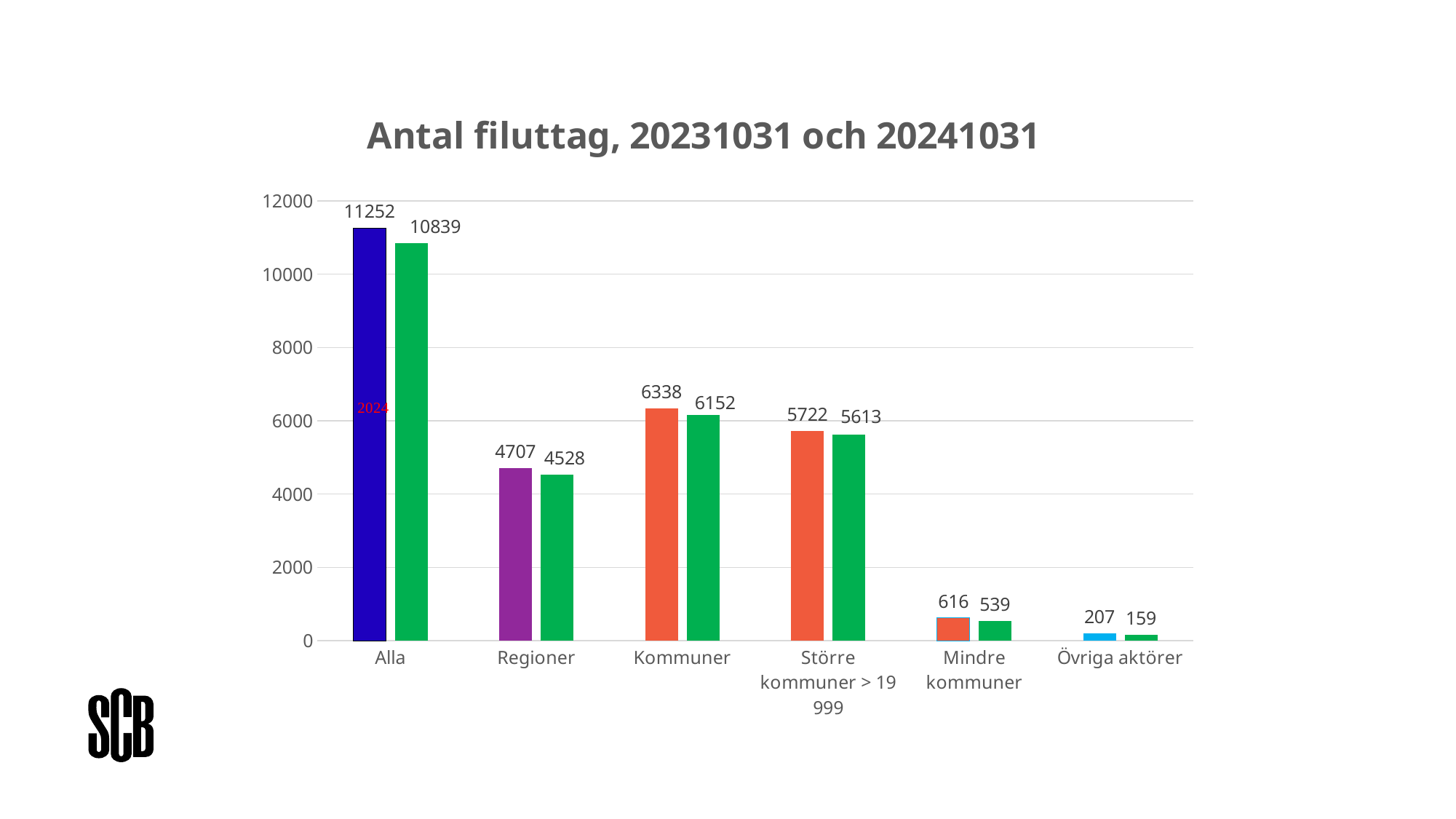
Which category has the highest values in the chart? Alla Which is larger: the left bar for Kommuner or the left bar for Större kommuner > 19 999? Kommuner What is the difference between the two bars for Mindre kommuner (616 and 539)? 77 What is the value shown on the green (right) bar for Övriga aktörer? 159 Is the green bar for Regioner greater or less than 4000? greater What type of chart is shown on the slide? Bar chart What is the difference between the two bars for Alla (11252 and 10839)? 413 What is the value shown on the green (right) bar for Regioner? 4528 Which category has the lowest values in the chart? Övriga aktörer What is the value shown on the left bar for Kommuner? 6338 How many categories are shown on the x axis? 6 What is the value shown on the left bar for Alla? 11252